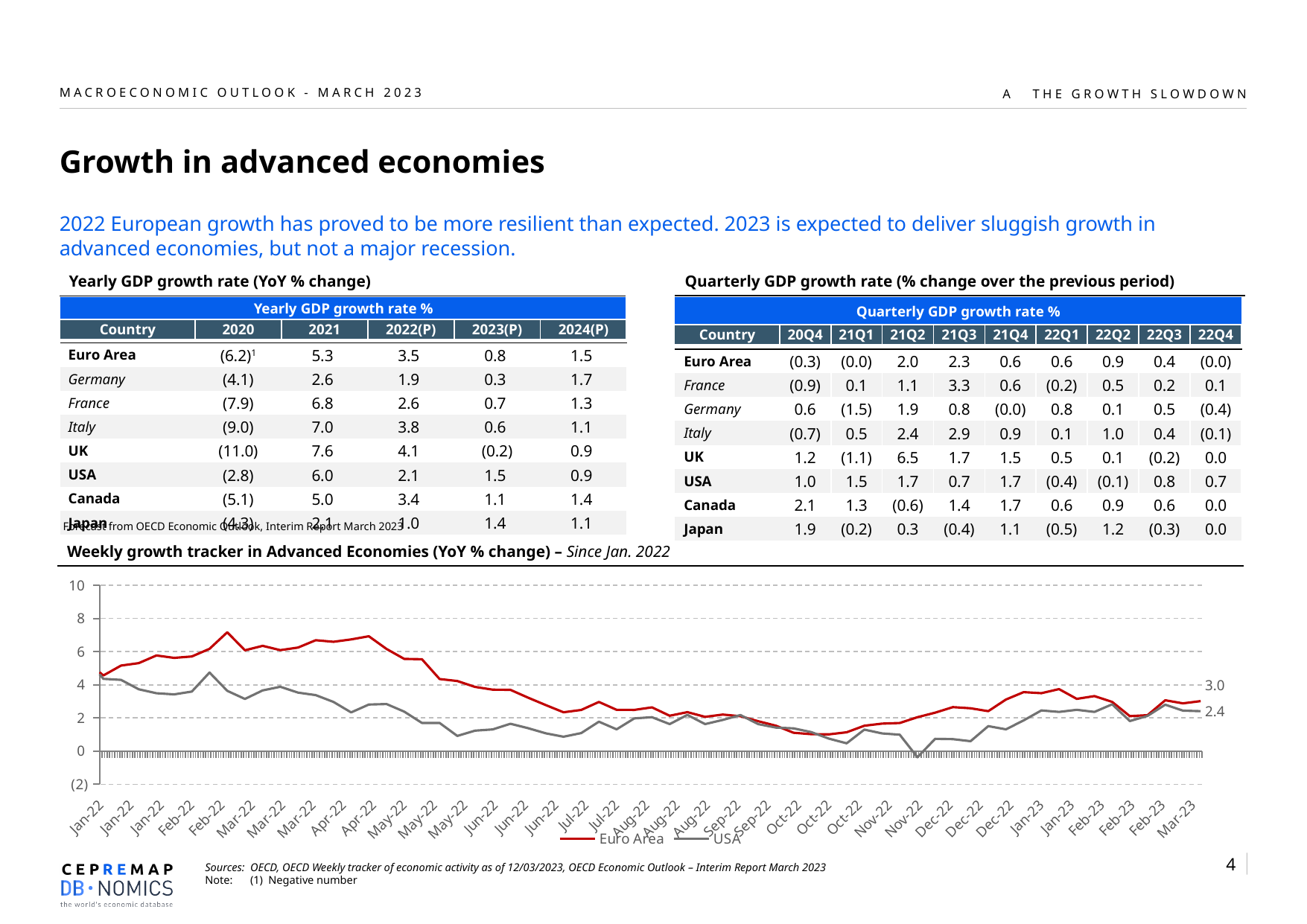
In the weekly growth tracker chart, which series is drawn in red? Euro Area In the weekly growth tracker chart, does the Euro Area series generally rise or fall between Apr-22 and Oct-22? fall What kind of chart is the 'Weekly growth tracker in Advanced Economies' chart? line chart In the weekly growth tracker chart, what is the latest labelled value for the Euro Area? 3.0 What is the title of the line chart on the slide? Weekly growth tracker in Advanced Economies (YoY % change) – Since Jan. 2022 In the weekly growth tracker chart, is the Euro Area value at its peak in Feb-22 greater or less than 6? greater How many series does the legend of the weekly growth tracker chart list? 2 In the weekly growth tracker chart, is the USA value in Jun-22 greater or less than 2? less In the weekly growth tracker chart, which series has the higher latest labelled value, Euro Area or USA? Euro Area In the weekly growth tracker chart, what is the latest labelled value for the USA? 2.4 In the weekly growth tracker chart, what is the difference between the latest labelled values for the Euro Area and the USA? 0.6